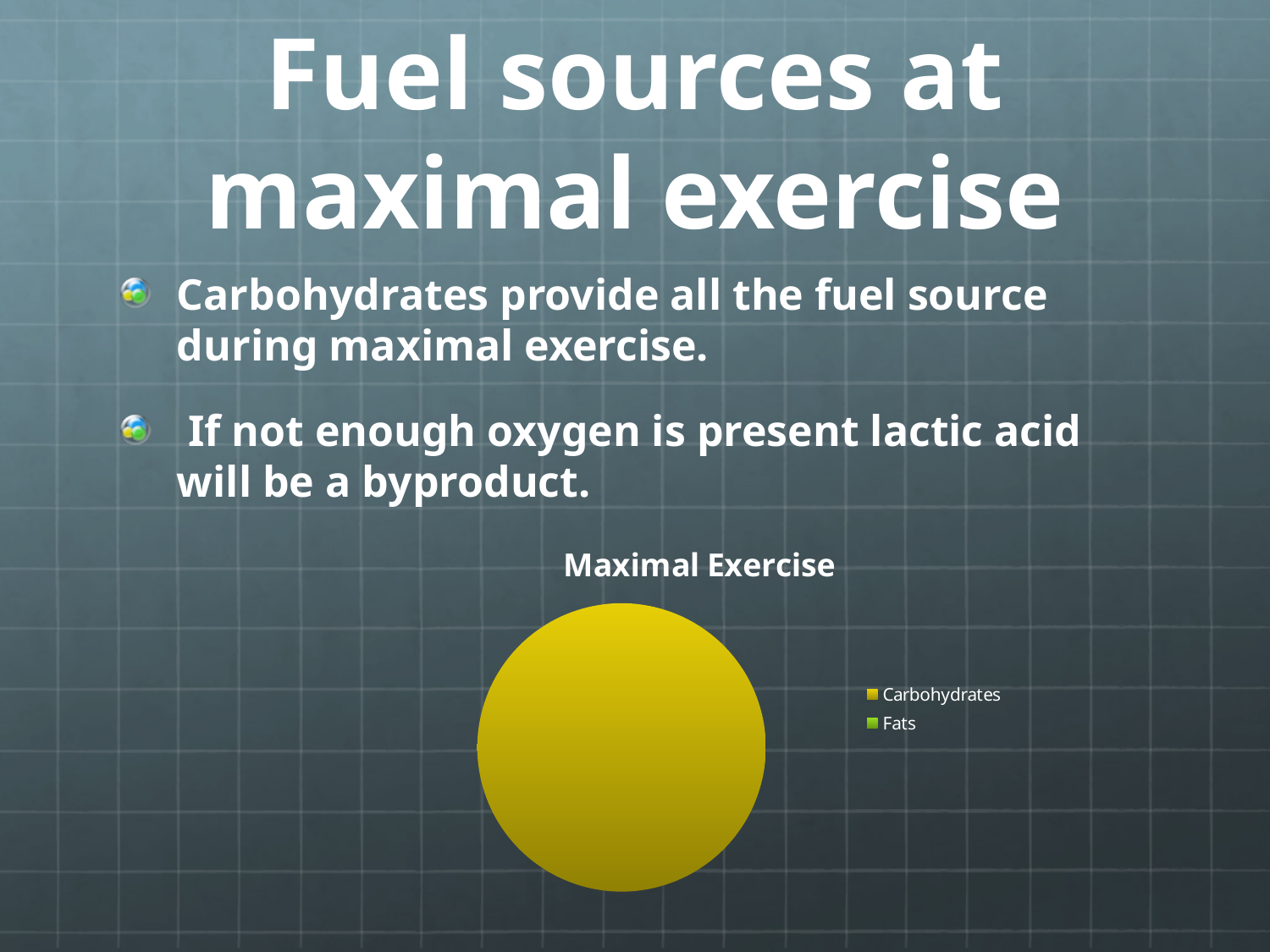
What colour represents Carbohydrates in the Maximal Exercise pie chart? yellow In the Maximal Exercise pie chart, which is larger: the Carbohydrates slice or the Fats slice? Carbohydrates How many entries does the chart's legend list? 2 What is the title of the chart on the slide? Maximal Exercise What kind of chart is shown on the slide? pie chart Which category has the smallest slice in the Maximal Exercise pie chart? Fats Which category fills the entire Maximal Exercise pie chart? Carbohydrates Which category has the largest slice in the Maximal Exercise pie chart? Carbohydrates